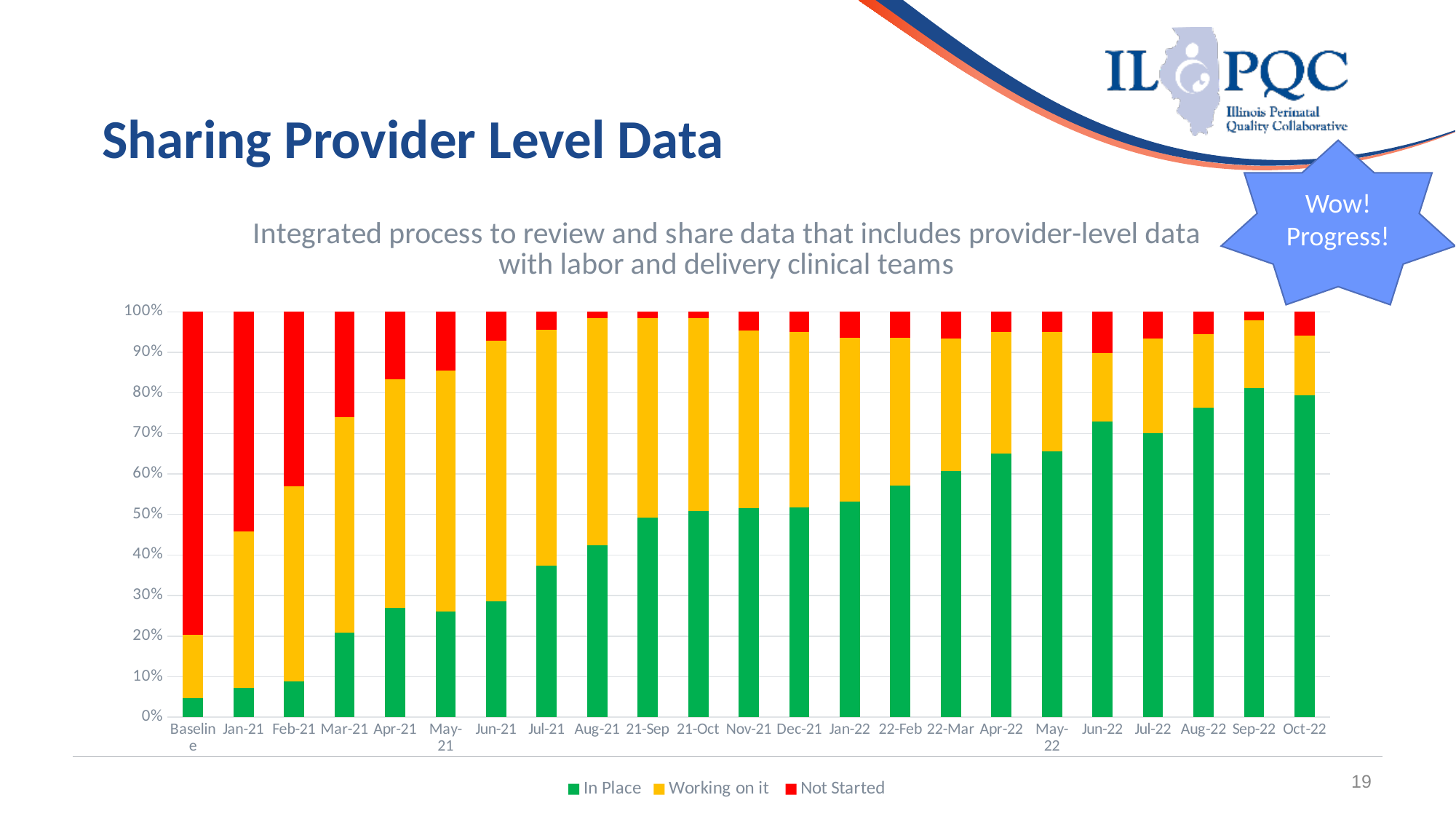
What kind of chart is shown on the slide? Stacked bar chart What is the title of the chart? Integrated process to review and share data that includes provider-level data with labor and delivery clinical teams Is the Not Started value for Baseline greater or less than 70%? greater Is the In Place value for Apr-21 greater or less than 20%? greater Which series is shown in red in the legend? Not Started Is the In Place value for Oct-22 greater or less than 70%? greater Which category has the largest Not Started share? Baseline How many series does the legend list? 3 Does the In Place share generally rise or fall from Baseline to Oct-22? rise How many time-period categories are shown on the x axis? 23 Which category has the smallest In Place share? Baseline